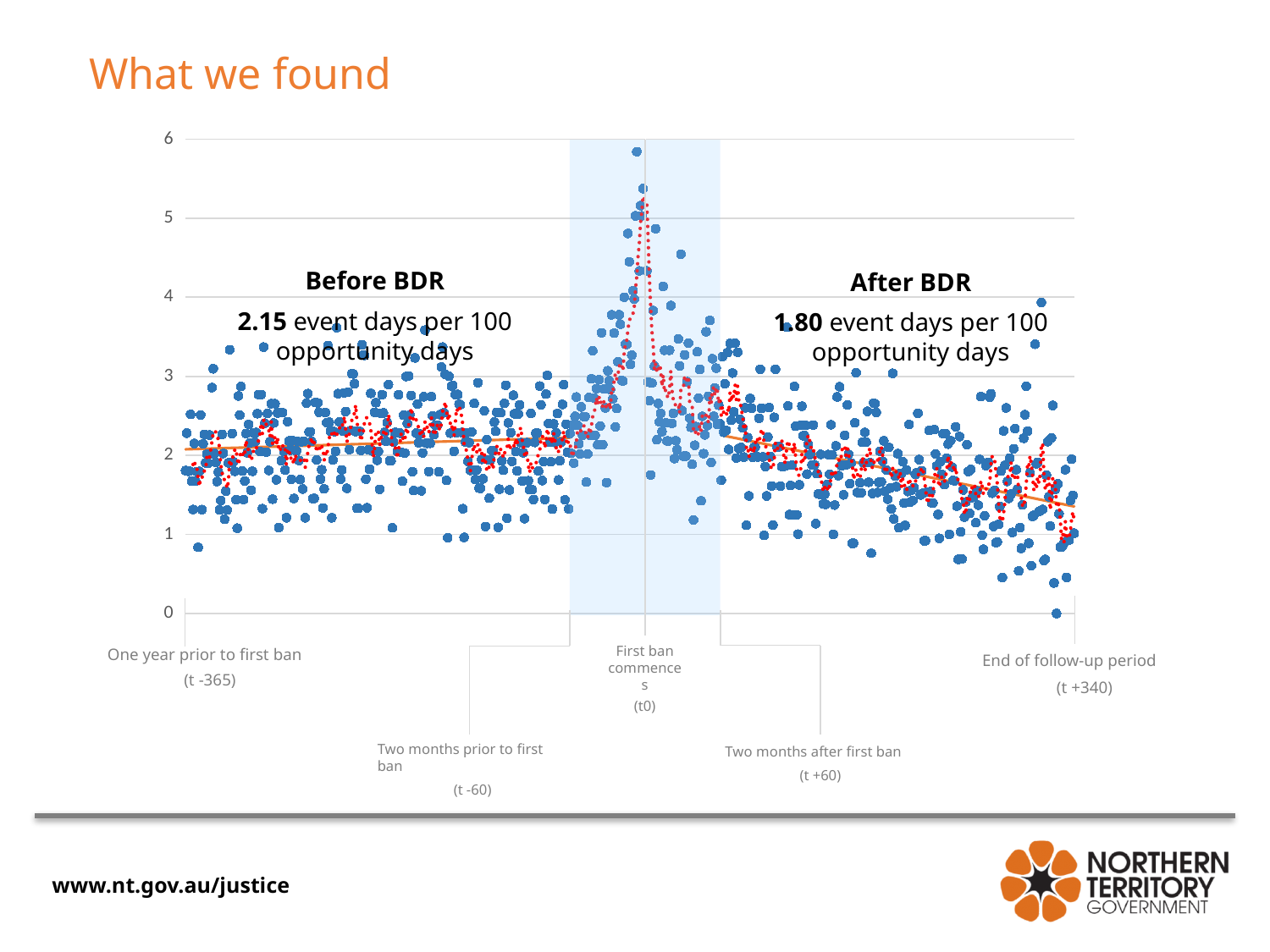
How many labelled time points are marked along the horizontal axis (t -365, t -60, t0, t +60, t +340)? 5 Is the highest plotted point, near the first ban commencement (t0), greater or less than 5? greater What is the rate of event days per 100 opportunity days after BDR? 1.80 Which is larger, the before-BDR rate or the after-BDR rate of event days per 100 opportunity days? Before BDR What kind of chart is shown on the slide? Scatter chart What is the maximum value shown on the vertical axis? 6 Is the lowest plotted point near the end of the follow-up period greater or less than 1? less Do the plotted values generally rise or fall after the first ban commences (after BDR)? Fall What is the difference between the before-BDR rate (2.15) and the after-BDR rate (1.80) of event days per 100 opportunity days? 0.35 What is the rate of event days per 100 opportunity days before BDR? 2.15 What is the title of the slide containing the chart? What we found What time point does the label 'End of follow-up period' correspond to? t +340